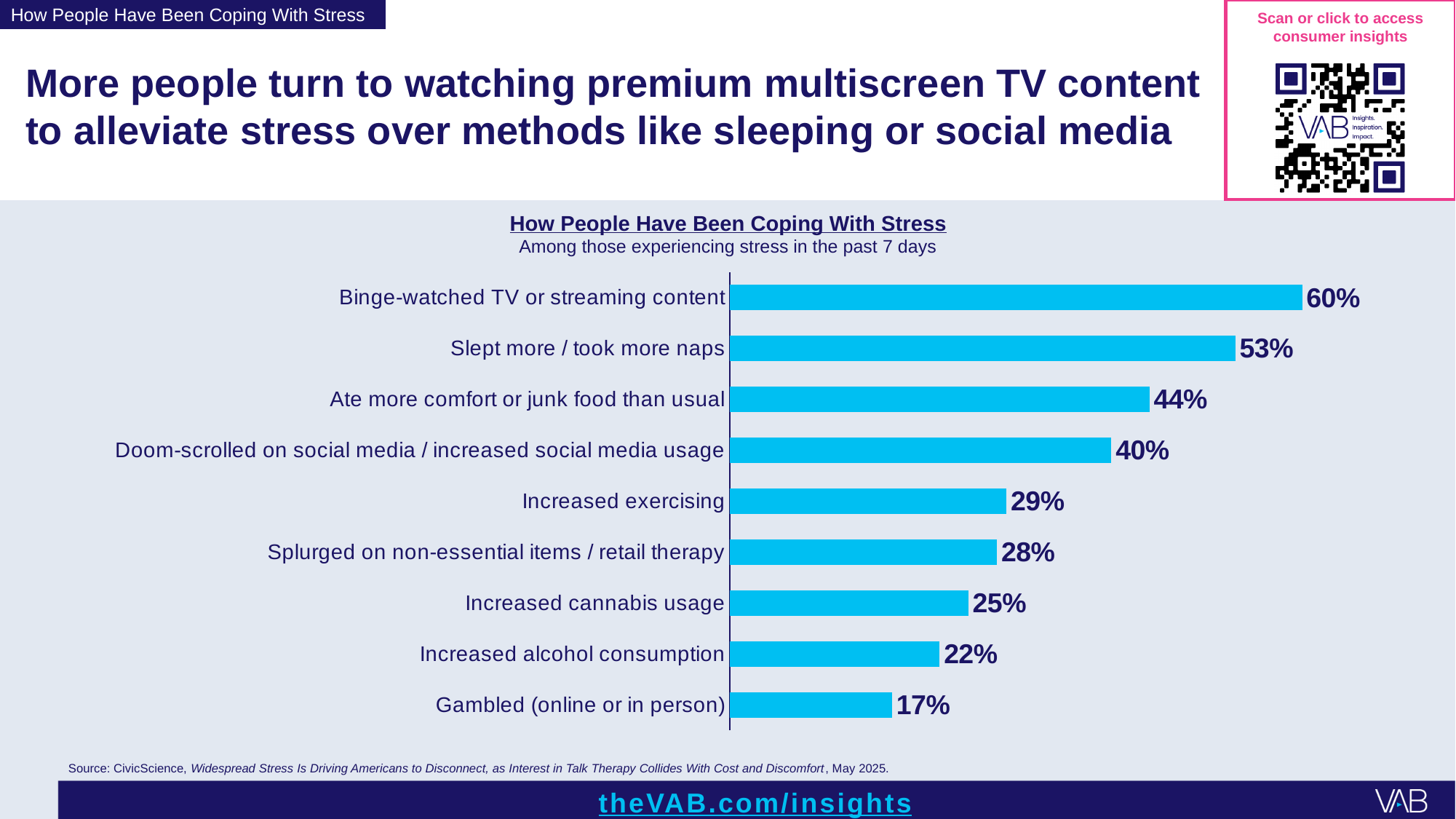
Which coping method has the lowest value? Gambled (online or in person) What percentage of people increased cannabis usage? 25% Which is larger: 'Increased exercising' or 'Gambled (online or in person)'? Increased exercising What percentage of people binge-watched TV or streaming content to cope with stress? 60% Which coping method has the highest value? Binge-watched TV or streaming content What is the difference between 'Binge-watched TV or streaming content' and 'Slept more / took more naps'? 7% What type of chart is shown on the slide? Bar chart What is the difference between 'Ate more comfort or junk food than usual' and 'Doom-scrolled on social media / increased social media usage'? 4% What is the value for 'Slept more / took more naps'? 53% How many coping methods are shown in the chart? 9 Which is larger: 'Increased alcohol consumption' or 'Increased cannabis usage'? Increased cannabis usage What is the subtitle of the chart, shown below its title? Among those experiencing stress in the past 7 days